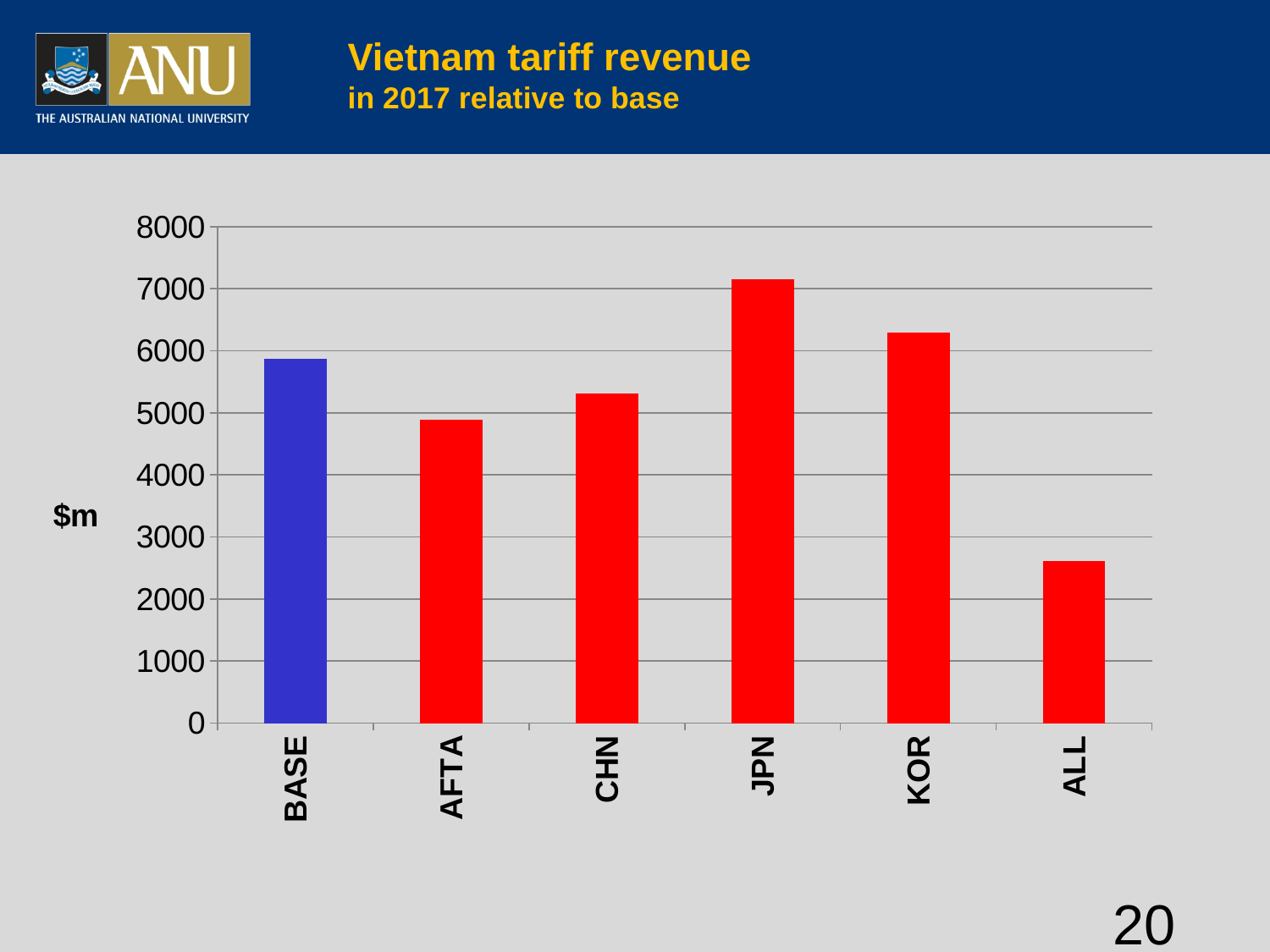
Is the value for AFTA greater or less than 5000? less Is the value for ALL greater or less than 3000? less Which category has the highest tariff revenue in the chart? JPN Which is larger, the value for BASE or the value for AFTA? BASE What is the label on the vertical axis of the chart? $m Is the value for JPN greater or less than 7000? greater What colour is the BASE bar in the chart? blue What kind of chart is shown on the slide? bar chart How many categories are shown on the x axis of the chart? 6 Which is larger, the value for JPN or the value for KOR? JPN Which category has the lowest tariff revenue in the chart? ALL